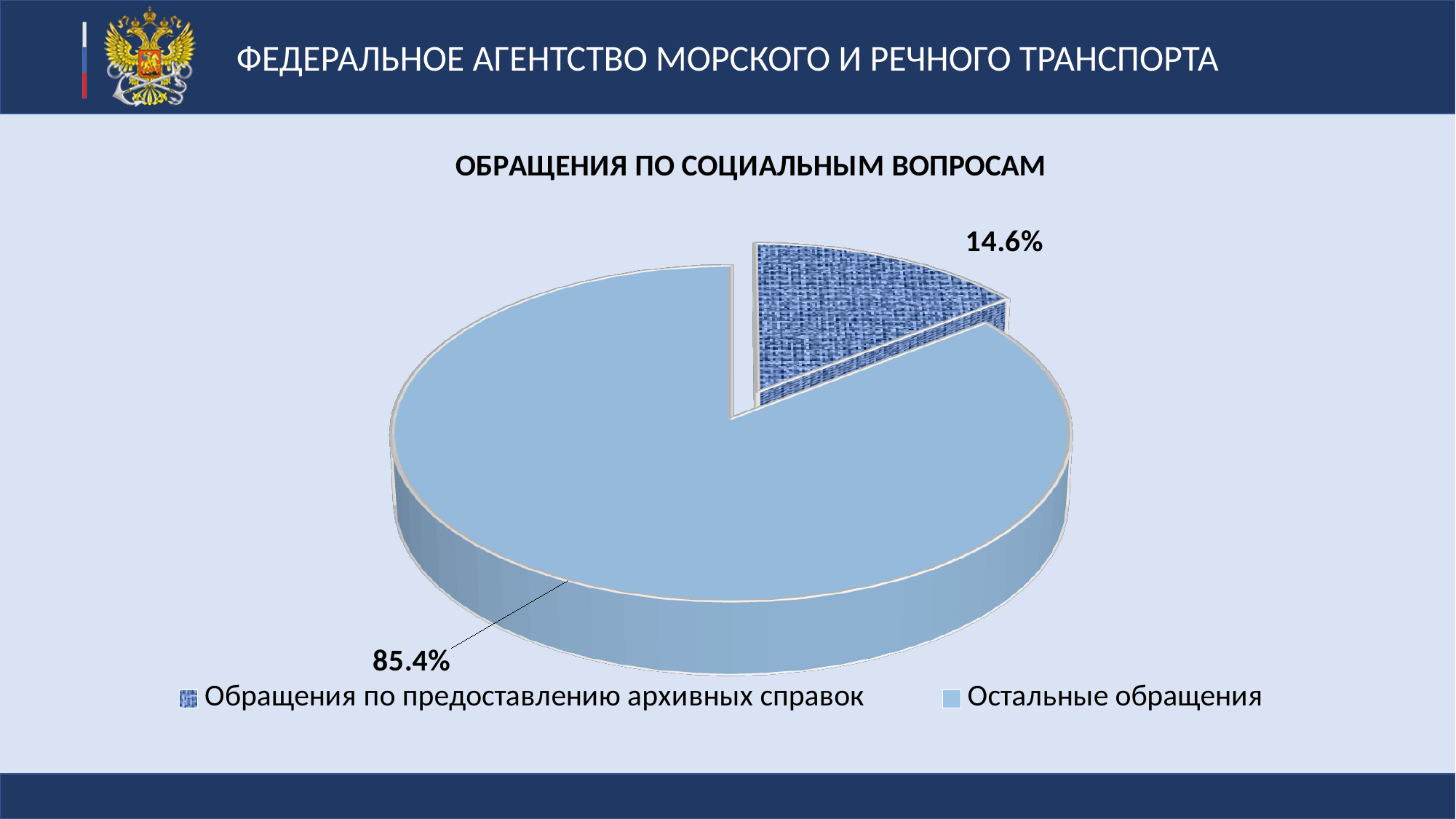
What is the total of the two percentages shown on the pie chart? 100% What is the title of the chart? ОБРАЩЕНИЯ ПО СОЦИАЛЬНЫМ ВОПРОСАМ What kind of chart is shown on the slide? Pie chart Which slice of the pie is the largest? Остальные обращения Which is larger: the share for "Обращения по предоставлению архивных справок" or the share for "Остальные обращения"? Остальные обращения What share of the pie is labelled for "Обращения по предоставлению архивных справок"? 14.6% What is the difference in percentage points between "Остальные обращения" and "Обращения по предоставлению архивных справок"? 70.8 Which legend entry is shown with a dark blue patterned fill? Обращения по предоставлению архивных справок What share of the pie is labelled for "Остальные обращения"? 85.4% How many entries does the legend list? 2 Which slice of the pie is the smallest? Обращения по предоставлению архивных справок How many slices does the pie chart have? 2